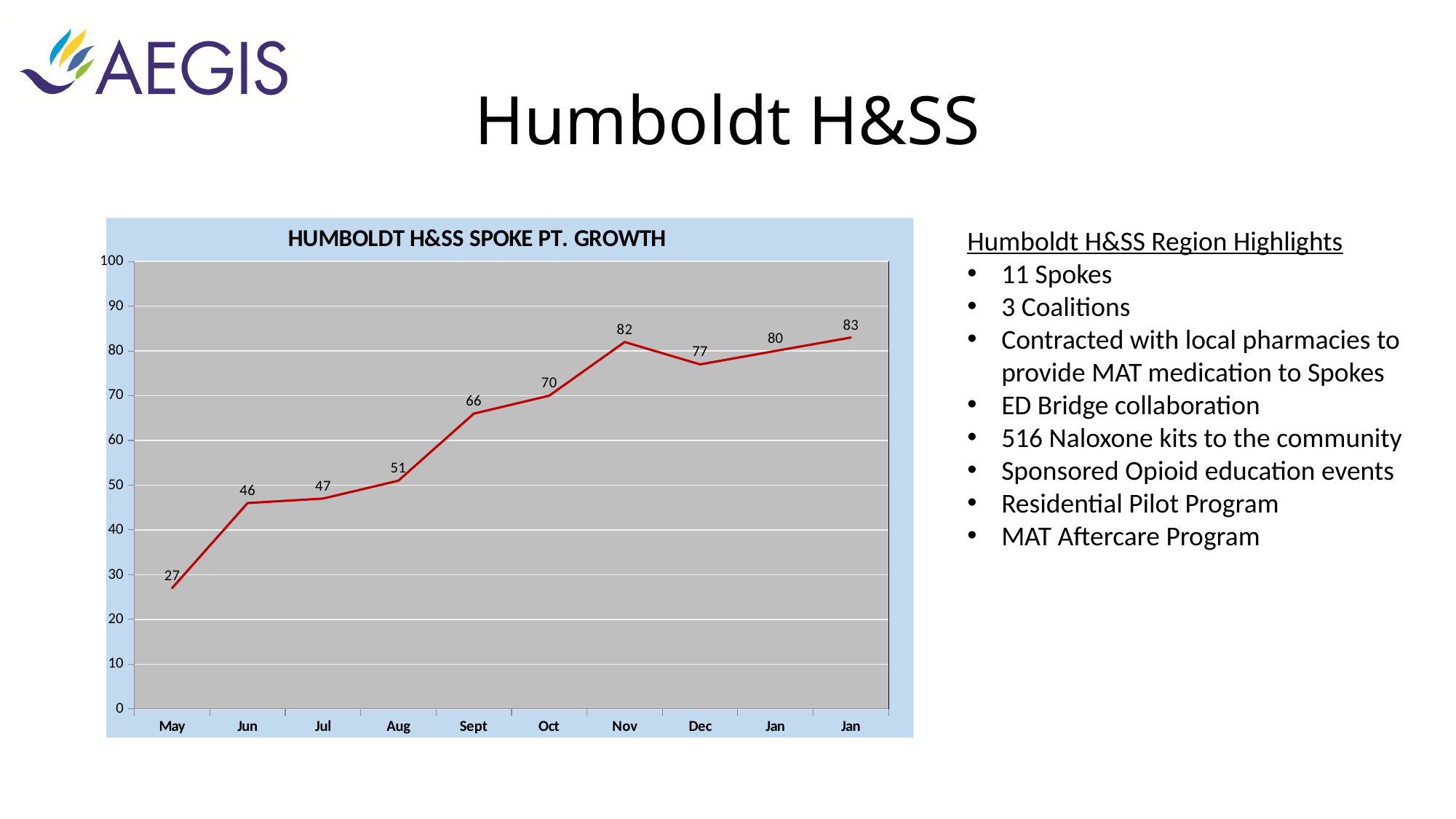
What is the value for May? 27 What is the title of the chart? HUMBOLDT H&SS SPOKE PT. GROWTH Which month has the highest value? Jan What is the value for Dec? 77 What is the value for Nov? 82 What is the difference between the values for Nov and Dec? 5 What is the value for Sept? 66 Which month has the lowest value? May What kind of chart is shown on the slide? line chart Do the values generally rise or fall from May to the final Jan? rise Which is larger, the value for Oct or the value for Dec? Dec How many data points are plotted on the chart? 10